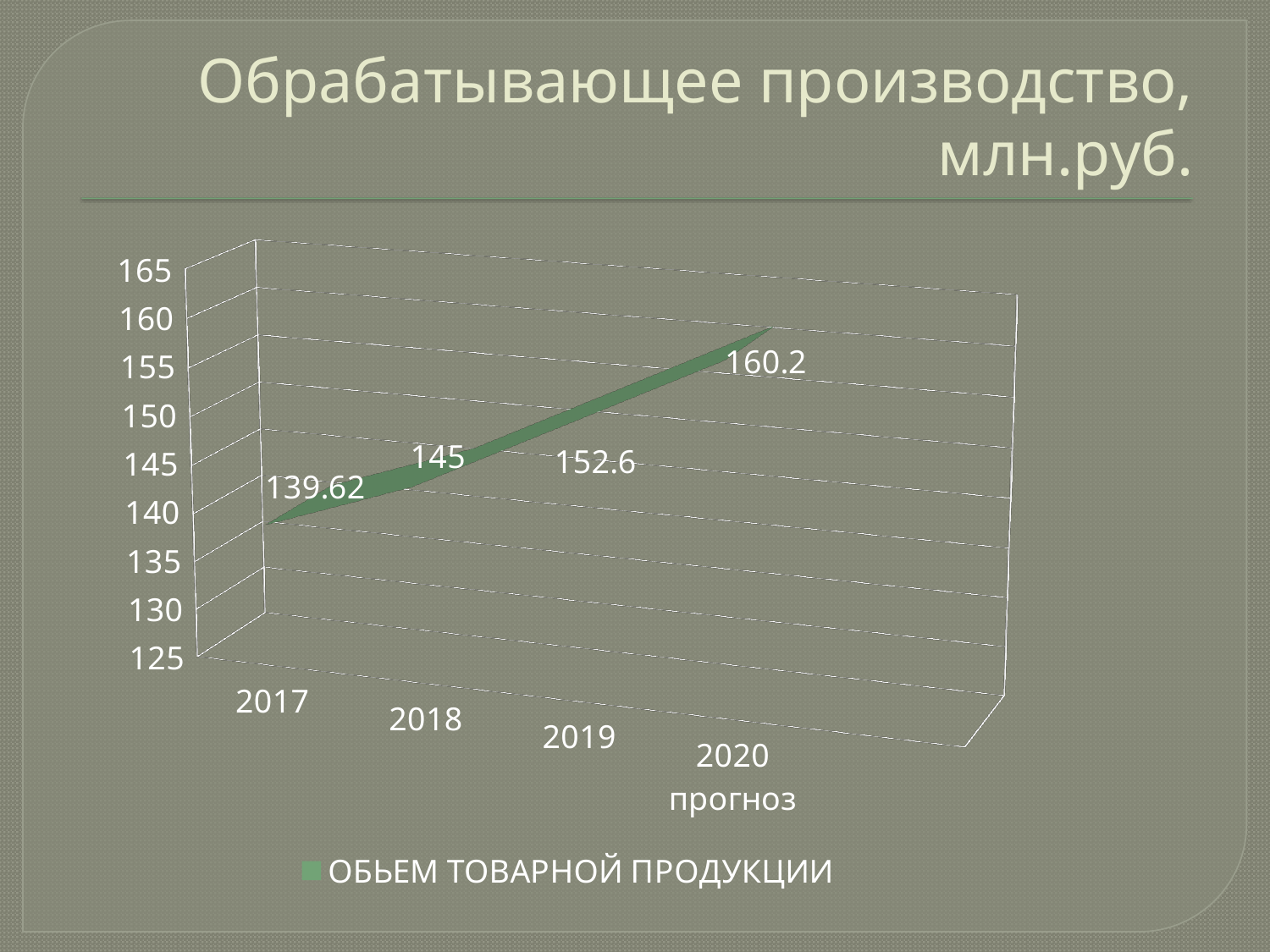
How many years are plotted on the x axis? 4 What is the difference between the values for 2020 прогноз and 2017? 20.58 Which year has the lowest value? 2017 What series name does the legend show? ОБЬЕМ ТОВАРНОЙ ПРОДУКЦИИ Which is larger, the value for 2018 or the value for 2019? 2019 What is the value for 2018? 145 Which year has the highest value? 2020 прогноз What is the difference between the values for 2019 and 2018? 7.6 Do the values rise or fall from 2017 to 2020 прогноз? rise What is the value for 2017? 139.62 What is the value for 2019? 152.6 What is the value for 2020 прогноз? 160.2